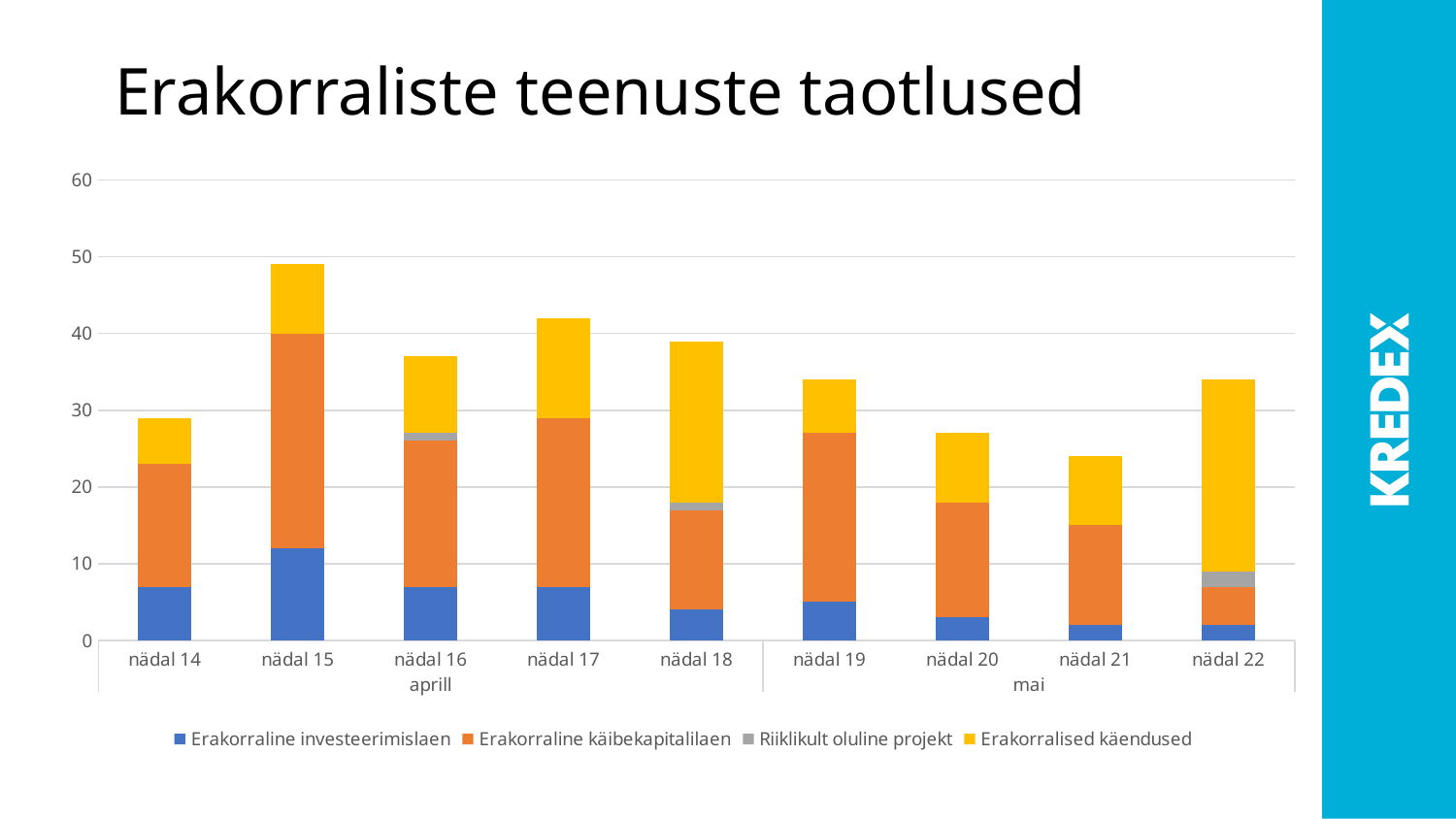
Do the total bar heights rise or fall from nädal 18 to nädal 21? fall Which week has the highest total stacked bar? nädal 15 How many weeks (categories) are shown on the x axis? 9 Is the total for nädal 21 greater or less than 30? less Which colour represents Erakorralised käendused in the legend? Yellow Which week has the lowest total stacked bar? nädal 21 Which has the larger total, nädal 15 or nädal 16? nädal 15 Is the total for nädal 15 greater or less than 40? greater How many series does the legend list? 4 What is the title of the chart? Erakorraliste teenuste taotlused What kind of chart is shown on the slide? Stacked bar chart Is the total for nädal 18 greater or less than 30? greater